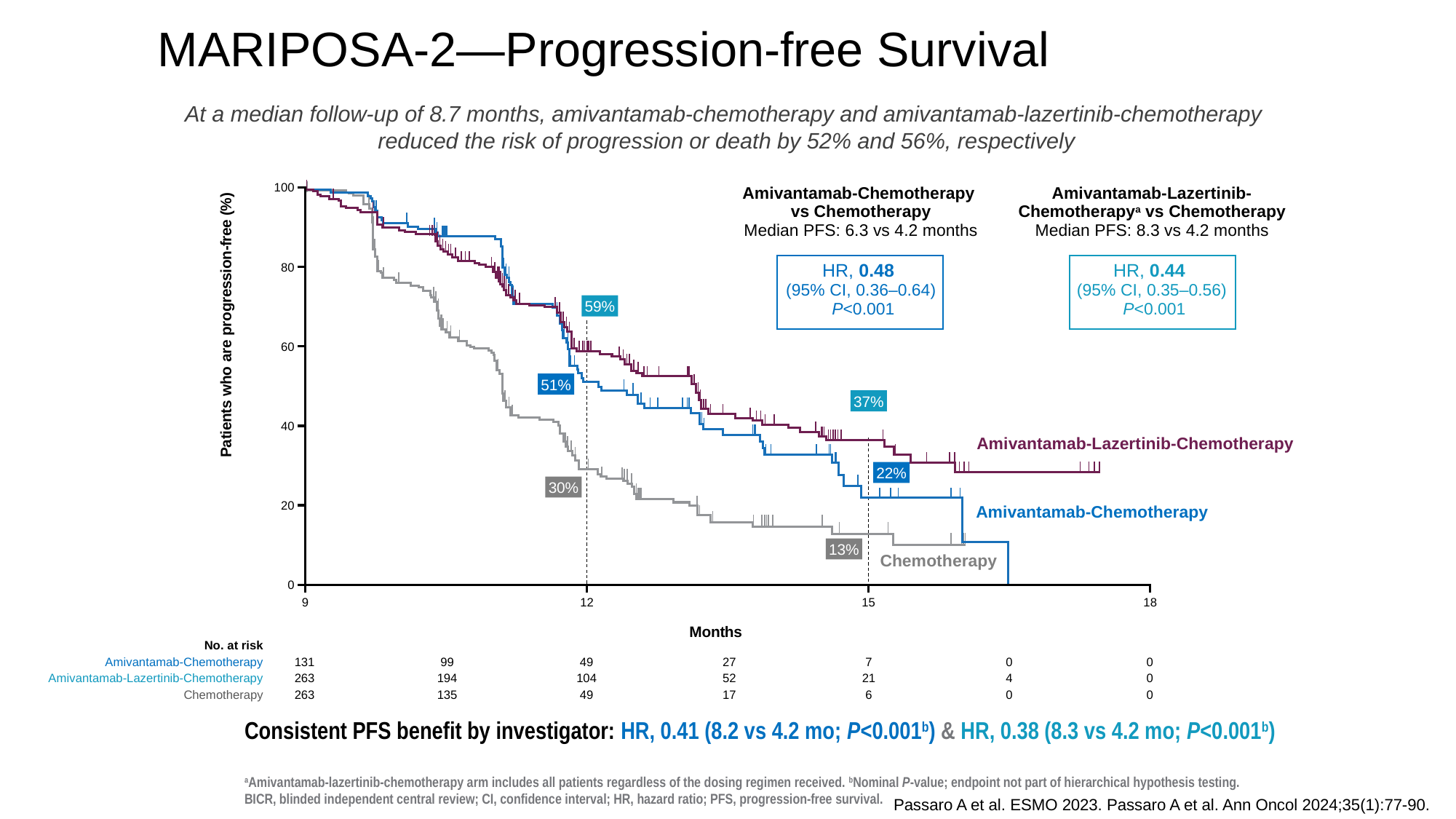
What percentage of patients are progression-free in the Amivantamab-Chemotherapy arm at the second dashed vertical line (x-axis tick 15)? 22% What is the hazard ratio for Amivantamab-Lazertinib-Chemotherapy versus Chemotherapy? 0.44 What percentage of patients are progression-free in the Chemotherapy arm at the first dashed vertical line (x-axis tick 12)? 30% What percentage of patients are progression-free in the Amivantamab-Lazertinib-Chemotherapy arm at the first dashed vertical line (x-axis tick 12)? 59% How many treatment arms are plotted on the progression-free survival chart? 3 Which arm has the lowest progression-free percentage at the second dashed vertical line (x-axis tick 15)? Chemotherapy What is the median PFS for Amivantamab-Chemotherapy versus Chemotherapy? 6.3 vs 4.2 months Do the progression-free survival curves rise or fall as months increase along the x axis? fall What kind of chart is shown on the slide? Kaplan-Meier survival curve (line chart) How many patients were at risk in the Amivantamab-Lazertinib-Chemotherapy arm in the first column of the number-at-risk table? 263 What is the difference in progression-free percentage between the Amivantamab-Lazertinib-Chemotherapy arm (59%) and the Chemotherapy arm (30%) at the first dashed vertical line? 29 percentage points Which comparison has the lower hazard ratio: Amivantamab-Chemotherapy vs Chemotherapy or Amivantamab-Lazertinib-Chemotherapy vs Chemotherapy? Amivantamab-Lazertinib-Chemotherapy vs Chemotherapy